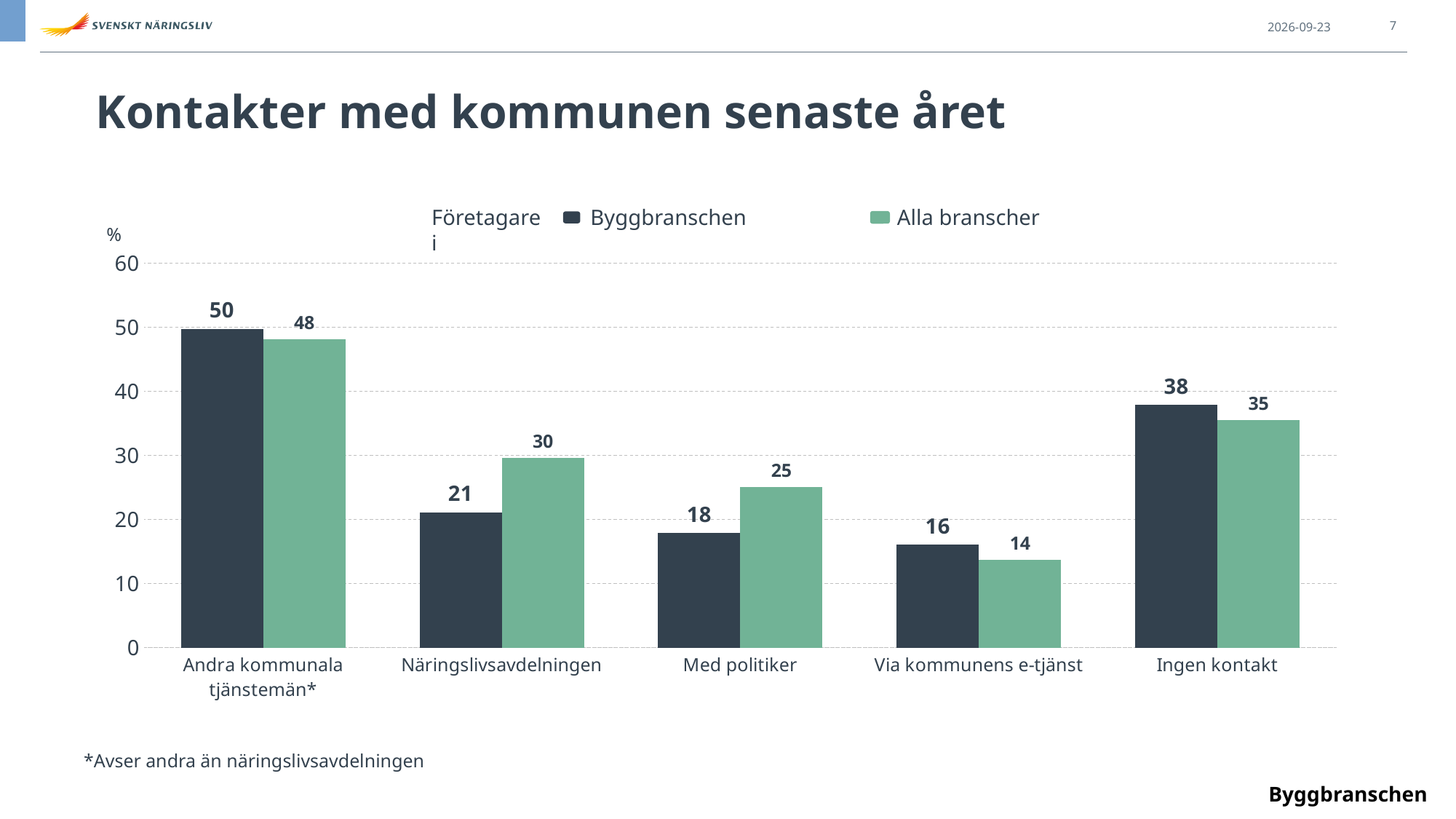
What is the value for Alla branscher in the category Näringslivsavdelningen? 30 What is the difference between Alla branscher and Byggbranschen in the category Med politiker? 7 What kind of chart is shown on the slide? Bar chart How many categories are shown on the x axis? 5 Which category has the highest value for Byggbranschen? Andra kommunala tjänstemän* What is the value for Byggbranschen in the category Ingen kontakt? 38 What is the value for Byggbranschen in the category Andra kommunala tjänstemän*? 50 What is the value for Alla branscher in the category Via kommunens e-tjänst? 14 In the category Näringslivsavdelningen, which series has the larger value, Byggbranschen or Alla branscher? Alla branscher How many series does the legend list? 2 Which category has the lowest value for Alla branscher? Via kommunens e-tjänst What is the title of the slide? Kontakter med kommunen senaste året